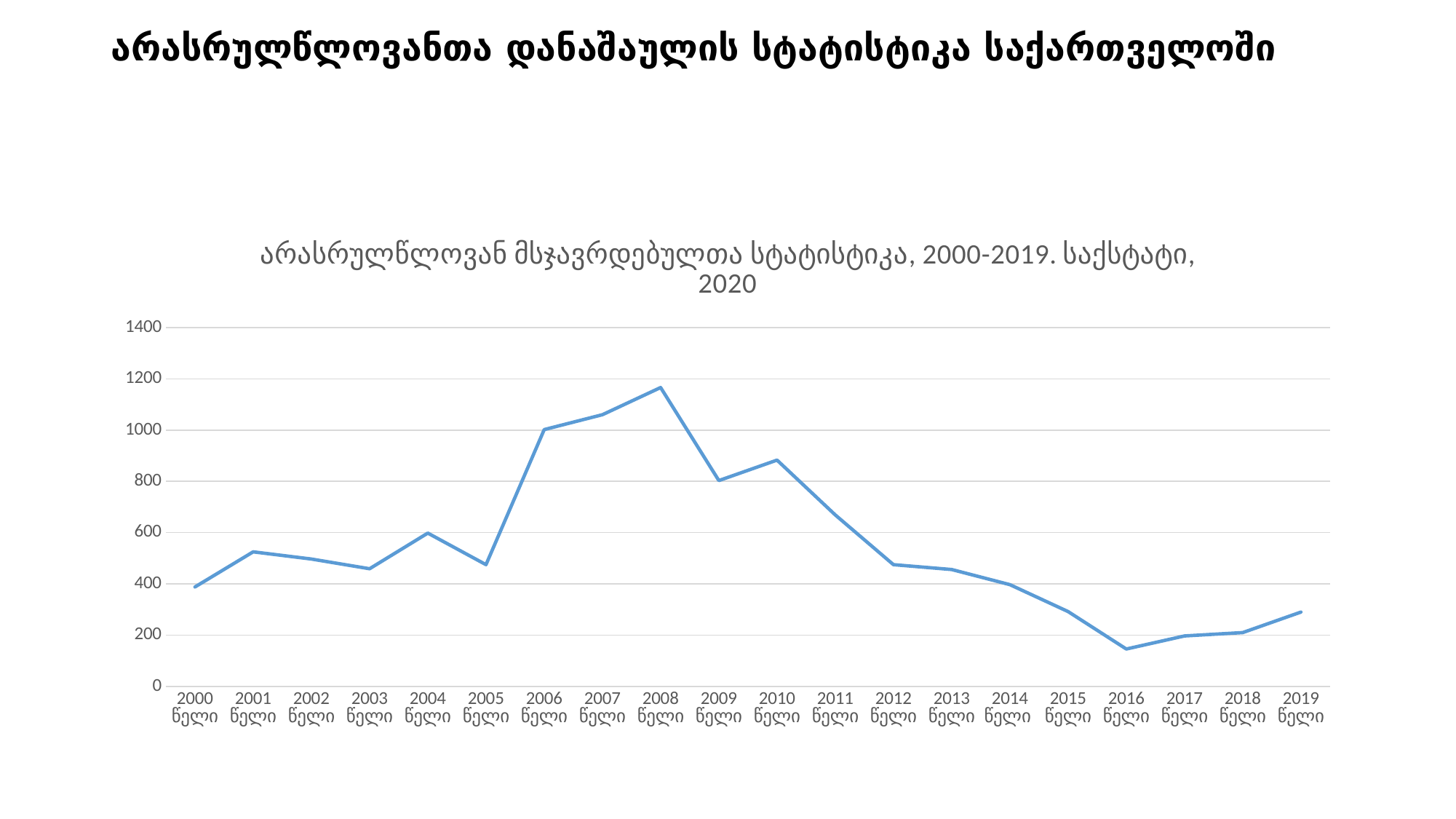
Which year has the larger value, 2008 or 2009? 2008 Which year has the larger value, 2005 or 2006? 2006 Is the value for 2015 greater or less than 400? less What is the first year shown on the x axis? 2000 Is the value for 2016 greater or less than 200? less How many years (data points) are plotted along the x axis? 20 Which year has the highest value on the chart? 2008 Is the value for 2008 greater or less than 1000? greater What kind of chart is shown on the slide? line chart Which year has the lowest value on the chart? 2016 Do the values rise or fall from 2008 to 2016? fall